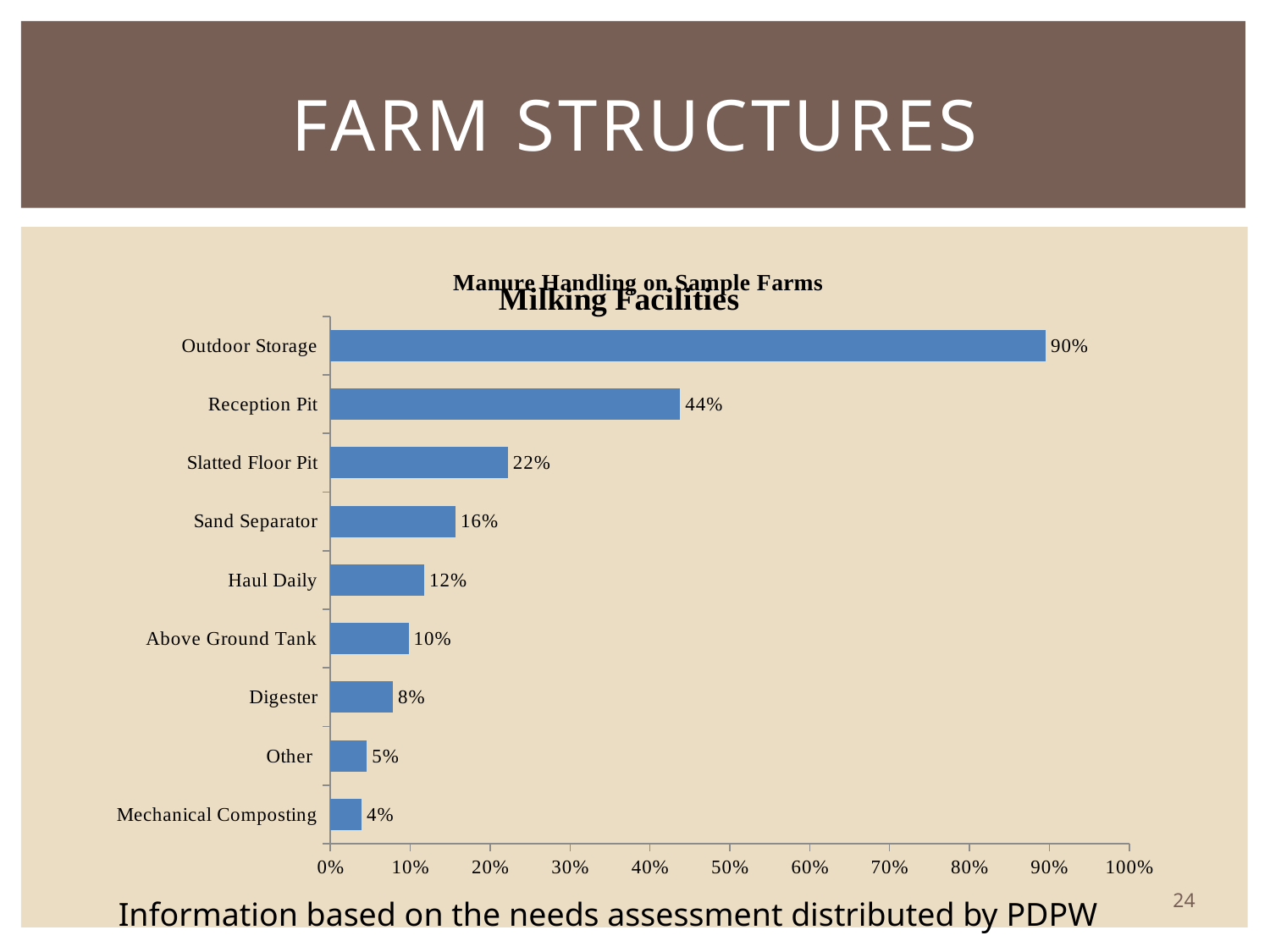
What is the difference between the values for Slatted Floor Pit and Haul Daily? 10% Which category has the lowest value? Mechanical Composting Which category has the highest value? Outdoor Storage Which is larger, the value for Above Ground Tank or the value for Other? Above Ground Tank What is the value for Outdoor Storage? 90% What is the value for Digester? 8% Is the value for Reception Pit greater or less than 40%? greater What kind of chart is shown on the slide? bar chart How many categories are shown in the chart? 9 What is the difference between the values for Outdoor Storage and Reception Pit? 46% What is the value for Sand Separator? 16%